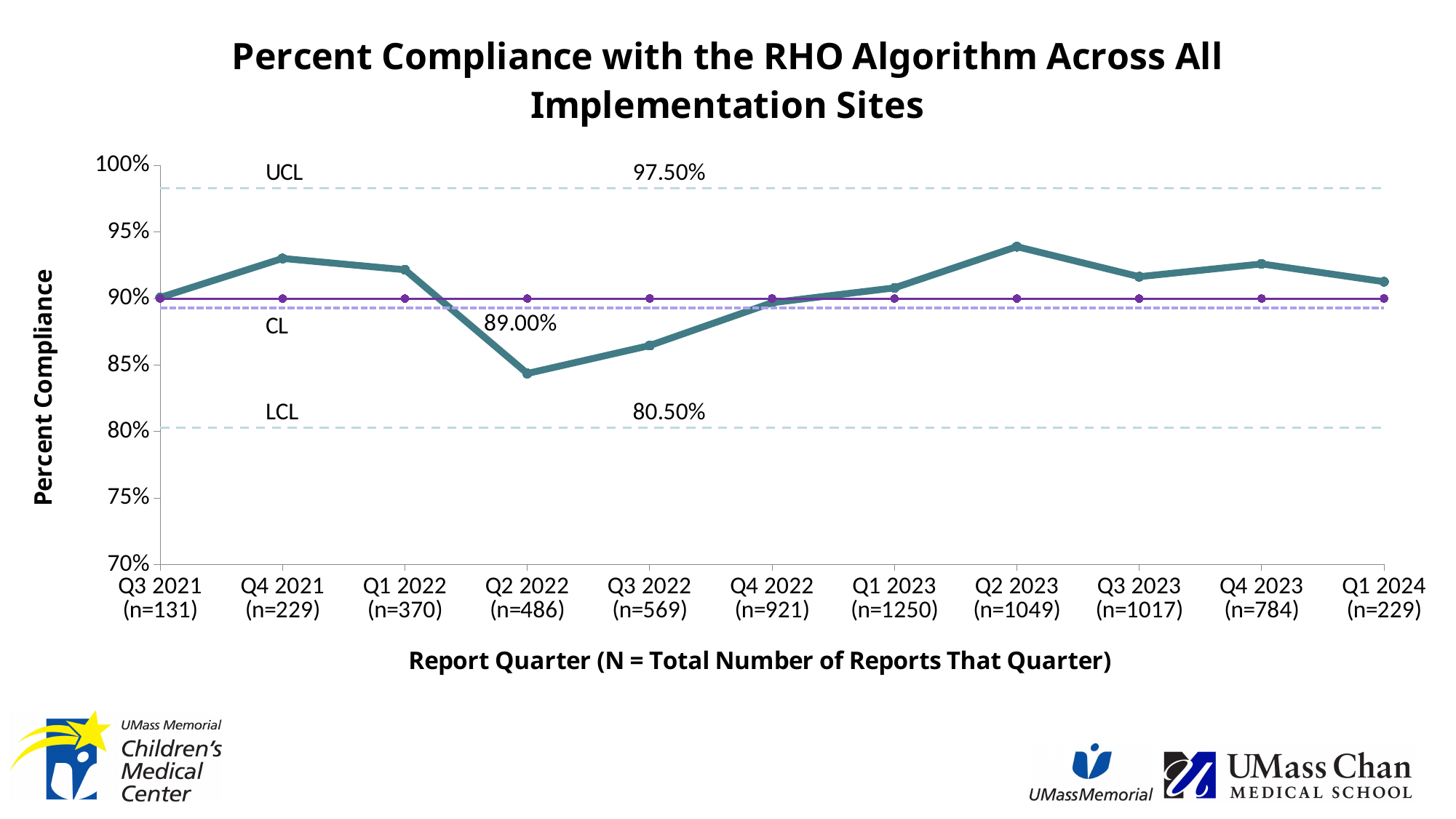
Which report quarter has the highest percent compliance? Q2 2023 What is the value of the lower control limit (LCL) shown on the chart? 80.50% How many reports (n) were there in Q1 2023? 1250 Is the percent compliance for Q3 2022 greater or less than 90%? less Which has the higher percent compliance, Q4 2021 or Q2 2022? Q4 2021 Is the percent compliance for Q2 2023 greater or less than 90%? greater Which report quarter has the lowest percent compliance? Q2 2022 What is the value of the upper control limit (UCL) shown on the chart? 97.50% What is the value of the center line (CL) shown on the chart? 89.00% What kind of chart is shown on the slide? line chart What is the difference between the UCL and the LCL values? 17.00% How many report quarters are plotted along the x axis? 11